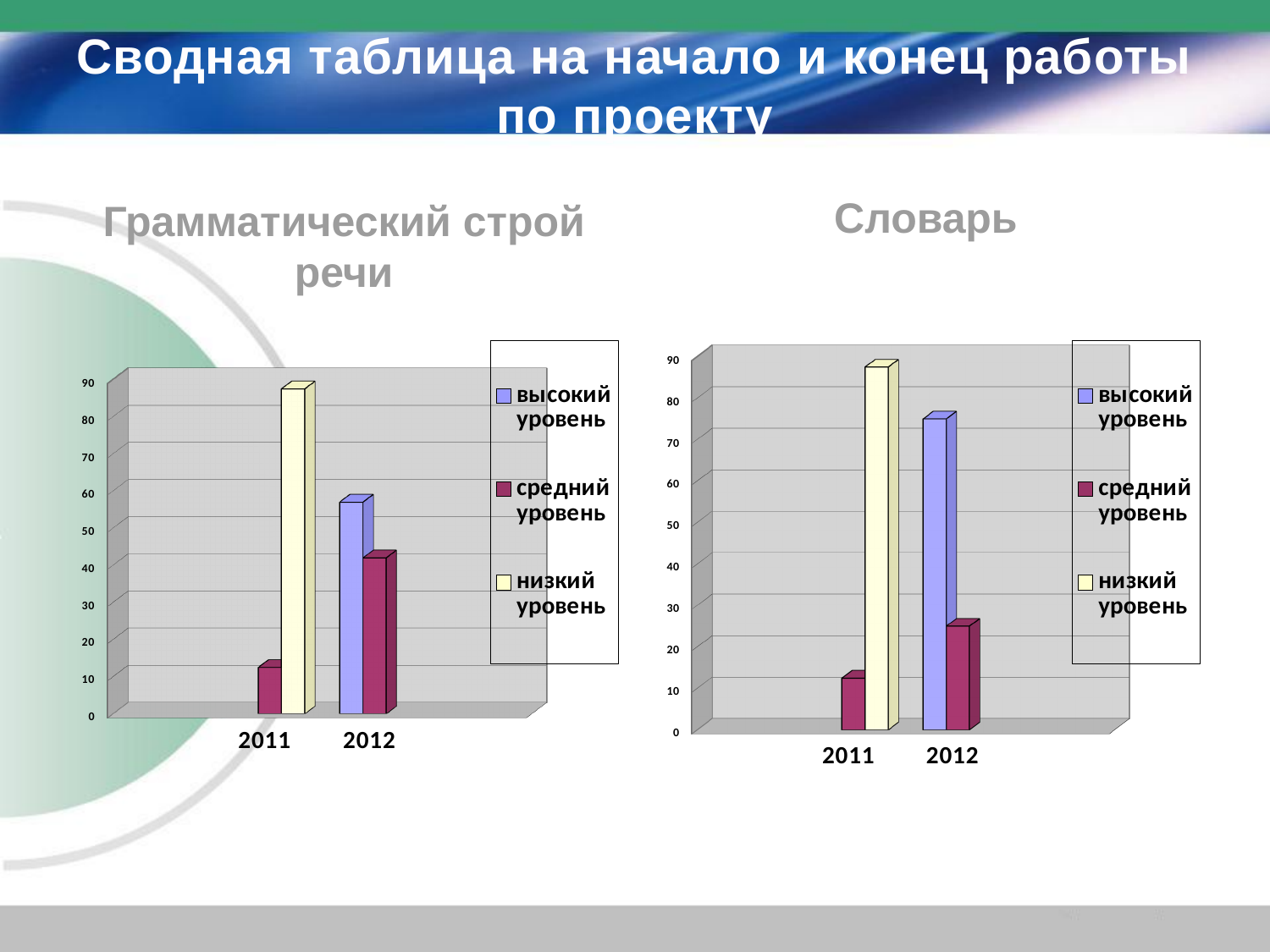
In the 'Словарь' chart, is the value for низкий уровень in 2011 greater or less than 80? greater How many categories are shown on the x axis of the 'Словарь' chart? 2 In the 'Грамматический строй речи' chart, is the value for низкий уровень in 2011 greater or less than 80? greater In the 'Словарь' chart, which is larger in 2011: низкий уровень or средний уровень? низкий уровень What are the three legend entries of the 'Грамматический строй речи' chart? высокий уровень, средний уровень, низкий уровень How many series does the legend of the 'Словарь' chart list? 3 In the 'Словарь' chart, is the value for средний уровень in 2012 greater or less than 30? less What kind of chart is the 'Грамматический строй речи' chart? bar chart In the 'Грамматический строй речи' chart, which is larger in 2012: высокий уровень or средний уровень? высокий уровень